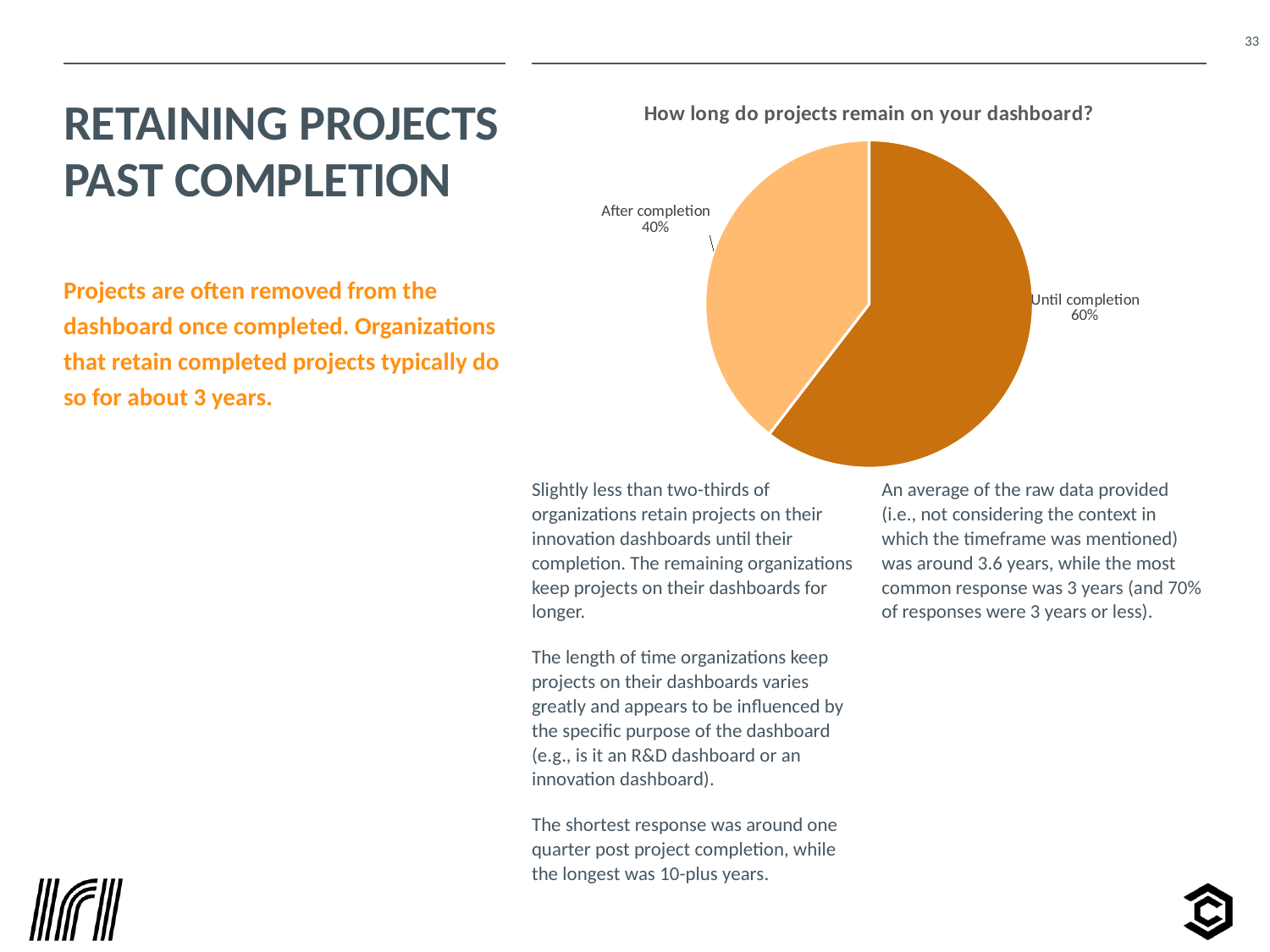
Which slice of the pie is the largest? Until completion Is the "After completion" share greater or less than 50%? less What is the title of the chart? How long do projects remain on your dashboard? What do the two slices of the pie add up to? 100% How many slices does the pie chart have? 2 What share of the pie is labelled "Until completion"? 60% Which slice is shown in the darker orange colour? Until completion What is the difference in percentage points between the "Until completion" and "After completion" slices? 20 Which slice of the pie is the smallest? After completion What share of the pie is labelled "After completion"? 40% What kind of chart is shown on the slide? pie chart Which is larger, the "Until completion" slice or the "After completion" slice? Until completion